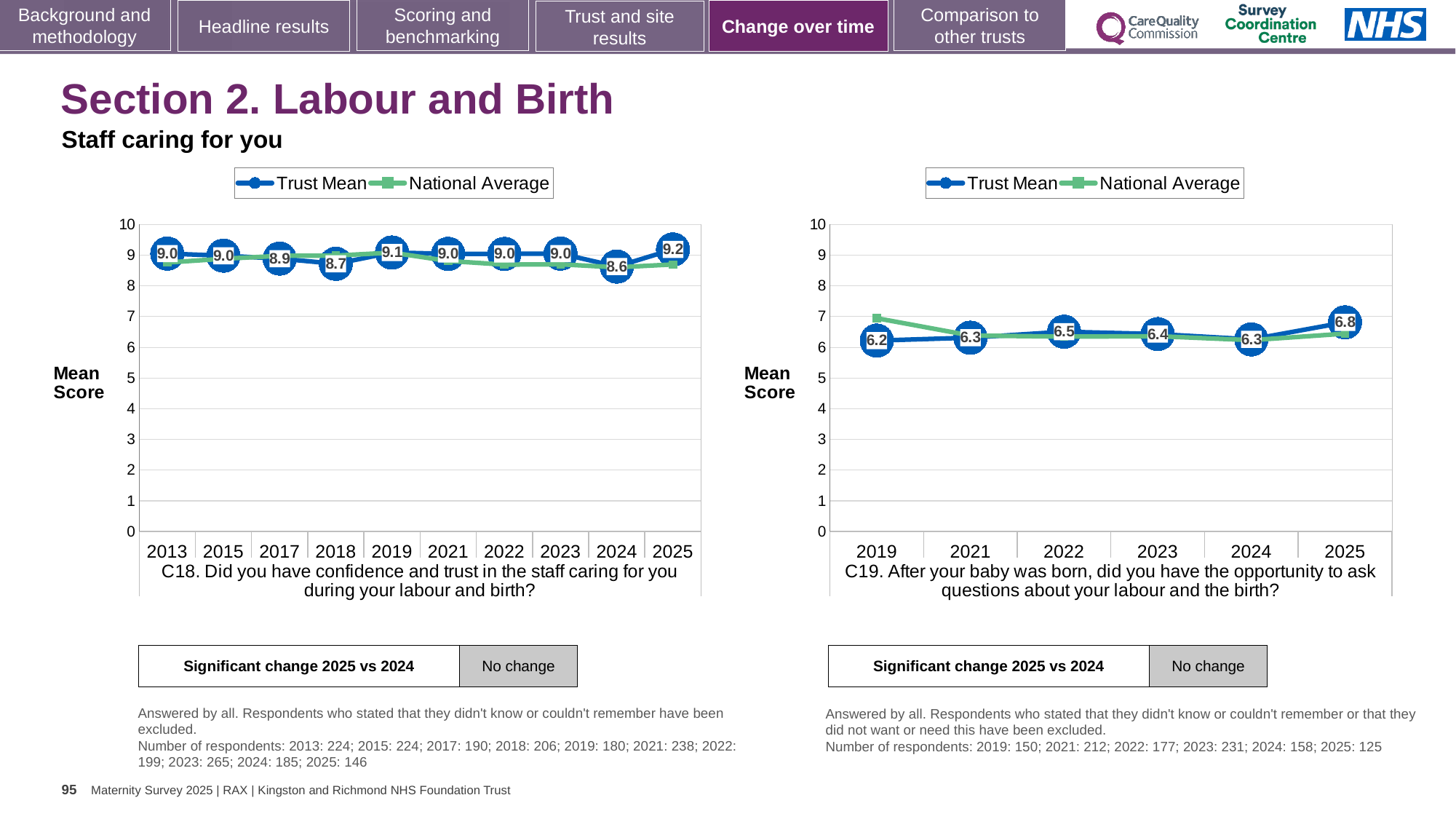
How many years are shown on the x axis of the C18 chart on the left? 10 In the C19 chart on the right, what is the Trust Mean for 2025? 6.8 In the C19 chart on the right, which year has the lowest Trust Mean? 2019 How many series does the legend of the C19 chart on the right list? 2 In the C18 chart on the left, what is the Trust Mean for 2024? 8.6 In the C18 chart on the left, which year has the highest Trust Mean? 2025 What type of chart is the C18 chart on the left? Line chart In the C19 chart on the right, is the Trust Mean for 2025 greater or less than 6? greater In the C18 chart on the left, which year has the lowest Trust Mean? 2024 In the C18 chart on the left, what is the Trust Mean for 2025? 9.2 In the C19 chart on the right, what is the difference between the Trust Mean for 2022 and 2019? 0.3 In the C18 chart on the left, what is the difference between the Trust Mean for 2025 and 2024? 0.6